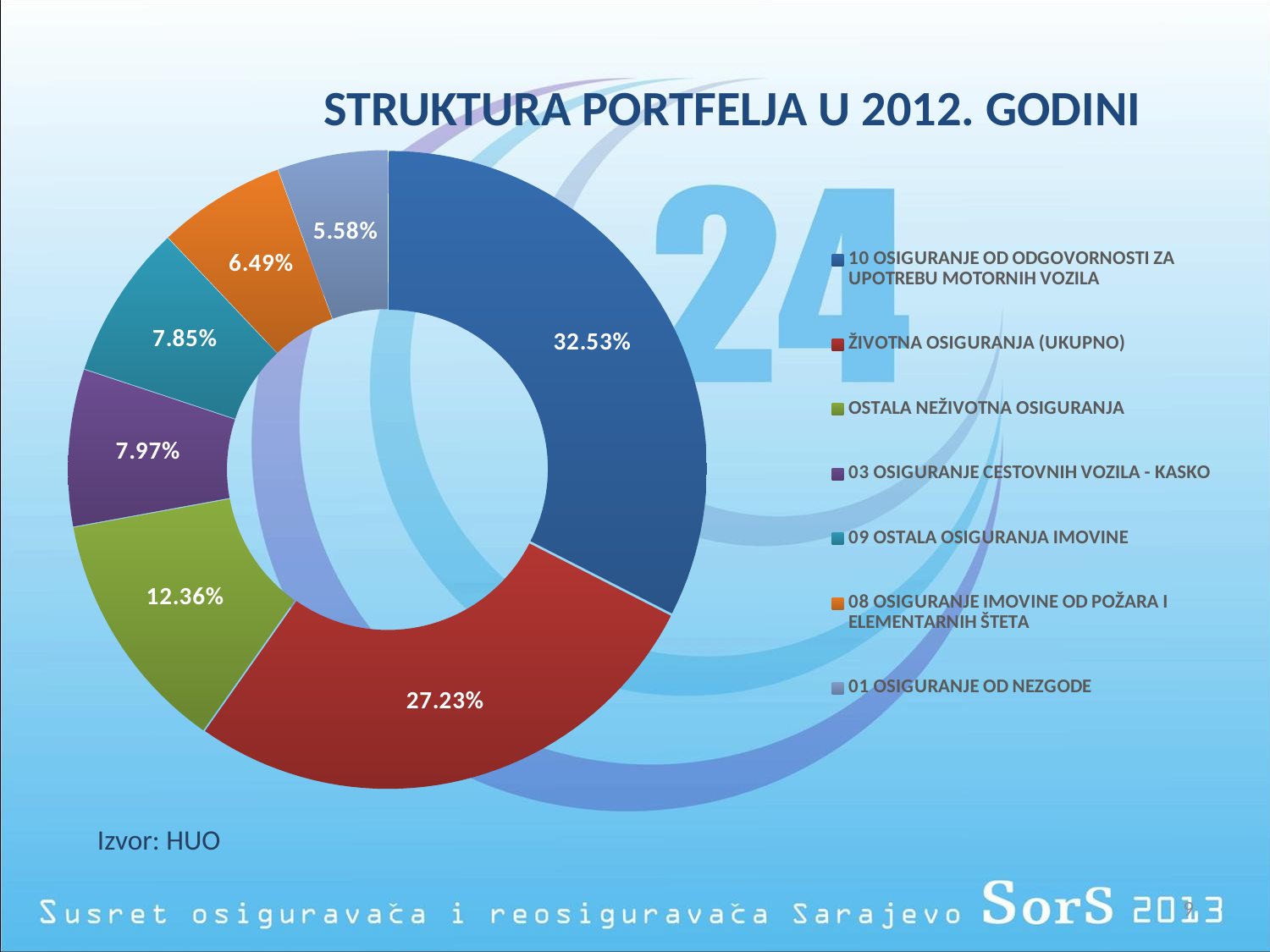
What is the title of the chart? STRUKTURA PORTFELJA U 2012. GODINI What is the difference between the shares of '10 OSIGURANJE OD ODGOVORNOSTI ZA UPOTREBU MOTORNIH VOZILA' and 'ŽIVOTNA OSIGURANJA (UKUPNO)'? 5.30% What share does 'OSTALA NEŽIVOTNA OSIGURANJA' have? 12.36% What kind of chart is shown on the slide? Doughnut (pie) chart Which category has the largest share? 10 OSIGURANJE OD ODGOVORNOSTI ZA UPOTREBU MOTORNIH VOZILA Which category has the smallest share? 01 OSIGURANJE OD NEZGODE What is the source cited below the chart? Izvor: HUO What share does '01 OSIGURANJE OD NEZGODE' have? 5.58% What share does 'ŽIVOTNA OSIGURANJA (UKUPNO)' have? 27.23% Which has a larger share: '08 OSIGURANJE IMOVINE OD POŽARA I ELEMENTARNIH ŠTETA' or 'OSTALA NEŽIVOTNA OSIGURANJA'? OSTALA NEŽIVOTNA OSIGURANJA How many slices does the chart have? 7 What share does '10 OSIGURANJE OD ODGOVORNOSTI ZA UPOTREBU MOTORNIH VOZILA' have? 32.53%